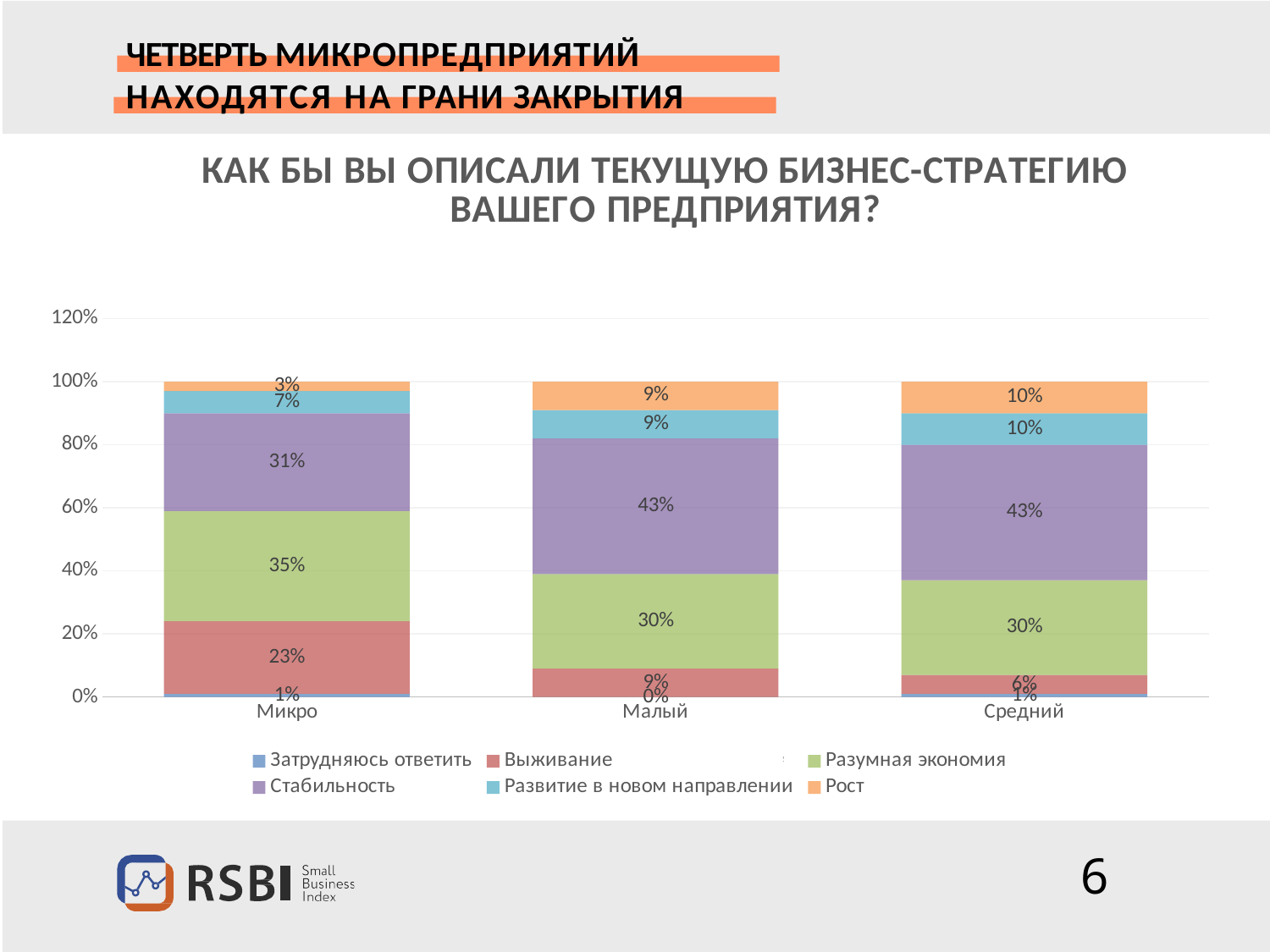
Which is larger: Стабильность for Микро or Стабильность for Малый? Малый What is the difference between the Выживание values for Микро and Средний? 17% Which category has the highest value for Выживание? Микро How many series does the chart legend list? 6 What is the value of Разумная экономия for Микро? 35% What is the title of the chart? КАК БЫ ВЫ ОПИСАЛИ ТЕКУЩУЮ БИЗНЕС-СТРАТЕГИЮ ВАШЕГО ПРЕДПРИЯТИЯ? What is the value of Стабильность for Малый? 43% What is the value of Рост for Средний? 10% What type of chart is shown on the slide? Stacked bar chart How many categories are shown on the x axis of the chart? 3 What is the value of Выживание for Микро? 23% Which category has the lowest value for Рост? Микро